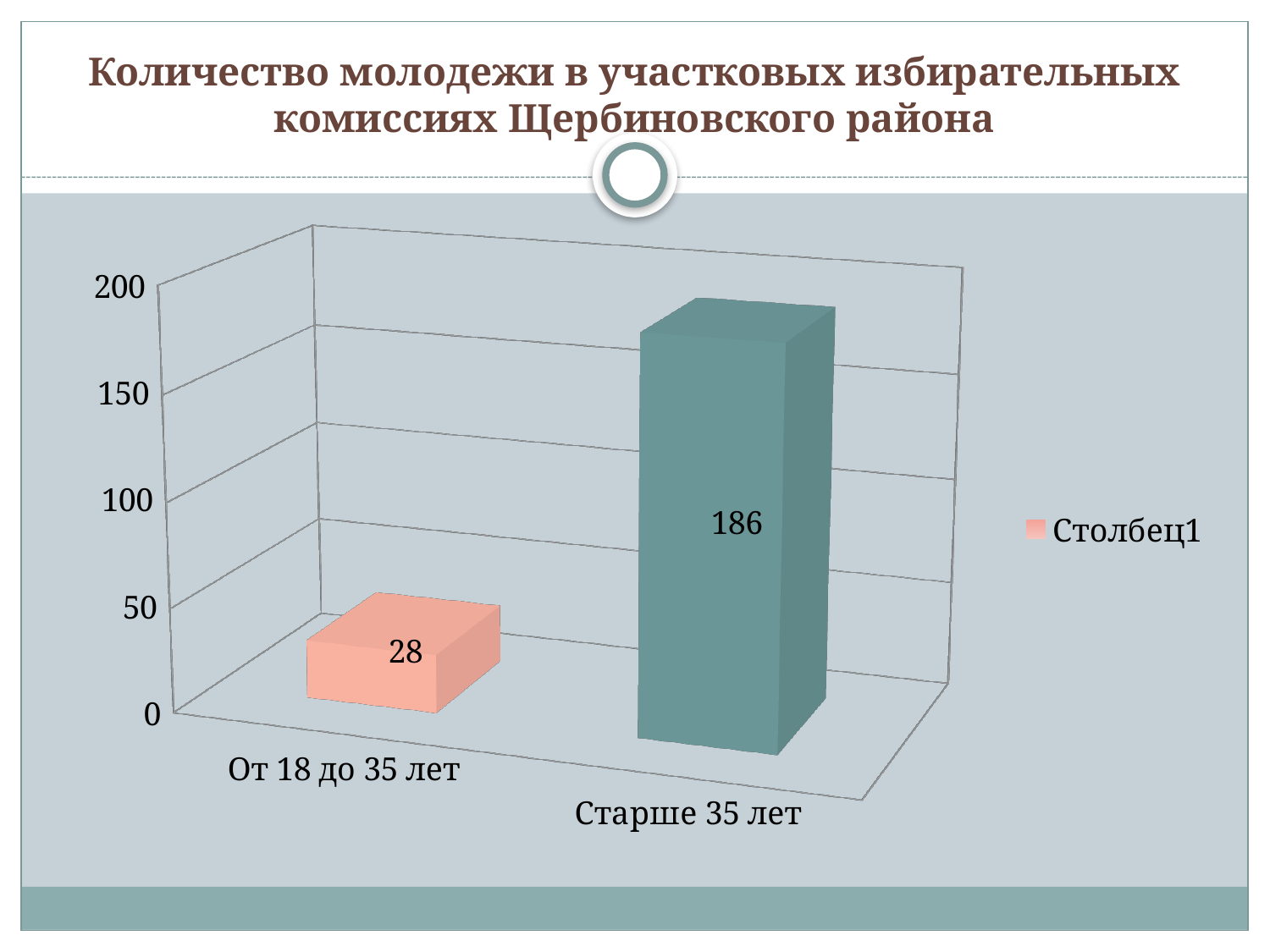
What is the difference between the values for "Старше 35 лет" and "От 18 до 35 лет"? 158 Which category has the highest value? Старше 35 лет What is the value for the category "Старше 35 лет"? 186 How many categories are shown on the chart? 2 What is the value for the category "От 18 до 35 лет"? 28 Which is larger: the value for "От 18 до 35 лет" or the value for "Старше 35 лет"? Старше 35 лет How many series does the legend list? 1 Is the value for "Старше 35 лет" greater or less than 150? greater Is the value for "От 18 до 35 лет" greater or less than 50? less Which category has the lowest value? От 18 до 35 лет What kind of chart is shown on the slide? bar chart What is the legend entry shown on the chart? Столбец1